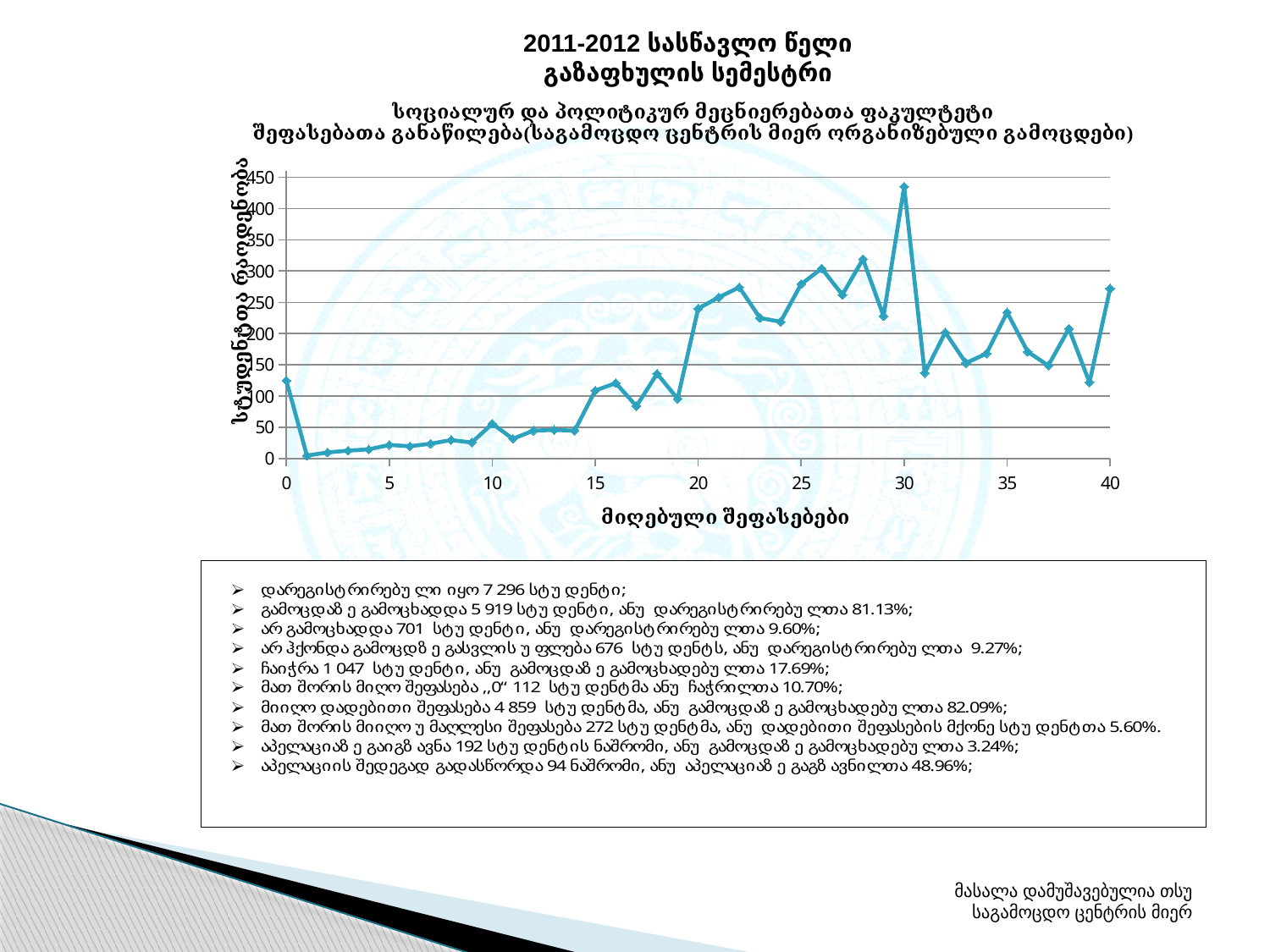
Overall, do the values rise or fall as the score increases from 1 to 30? rise Which has the larger value: score 0 or score 1? score 0 At which score on the x axis does the line reach its lowest value? 1 Is the value at score 30 greater or less than 400? greater Is the value at score 10 greater or less than 100? less Is the value at score 35 greater or less than 250? less Which has the larger value: score 30 or score 20? score 30 What kind of chart is shown on the slide? line chart What is the label of the x axis? მიღებული შეფასებები At which score on the x axis does the line reach its highest value? 30